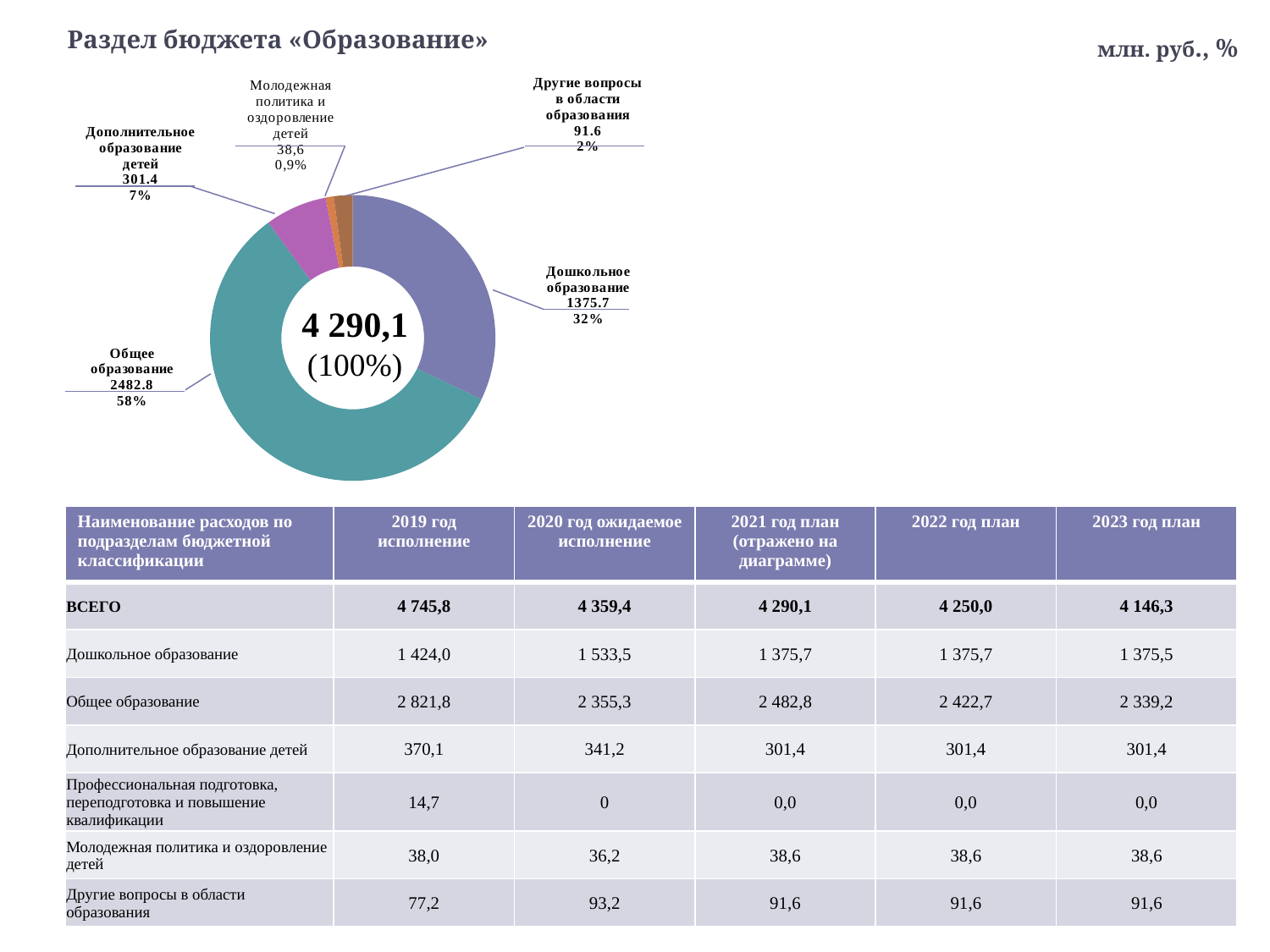
What type of chart is shown on the slide? Pie (donut) chart What share does Молодежная политика и оздоровление детей have in the chart? 0,9% What is the difference between the values for Общее образование and Дошкольное образование in the chart? 1107.1 What is the value shown for Другие вопросы в области образования in the chart? 91.6 Which category has the smallest slice in the chart? Молодежная политика и оздоровление детей How many slices does the chart have? 5 Which category has the largest slice in the chart? Общее образование What total value is shown in the centre of the chart? 4 290,1 Which is larger in the chart: Дополнительное образование детей or Другие вопросы в области образования? Дополнительное образование детей What share of the total does Общее образование account for in the chart? 58% What is the value shown for Дошкольное образование in the chart? 1375.7 What is the value shown for Дополнительное образование детей in the chart? 301.4